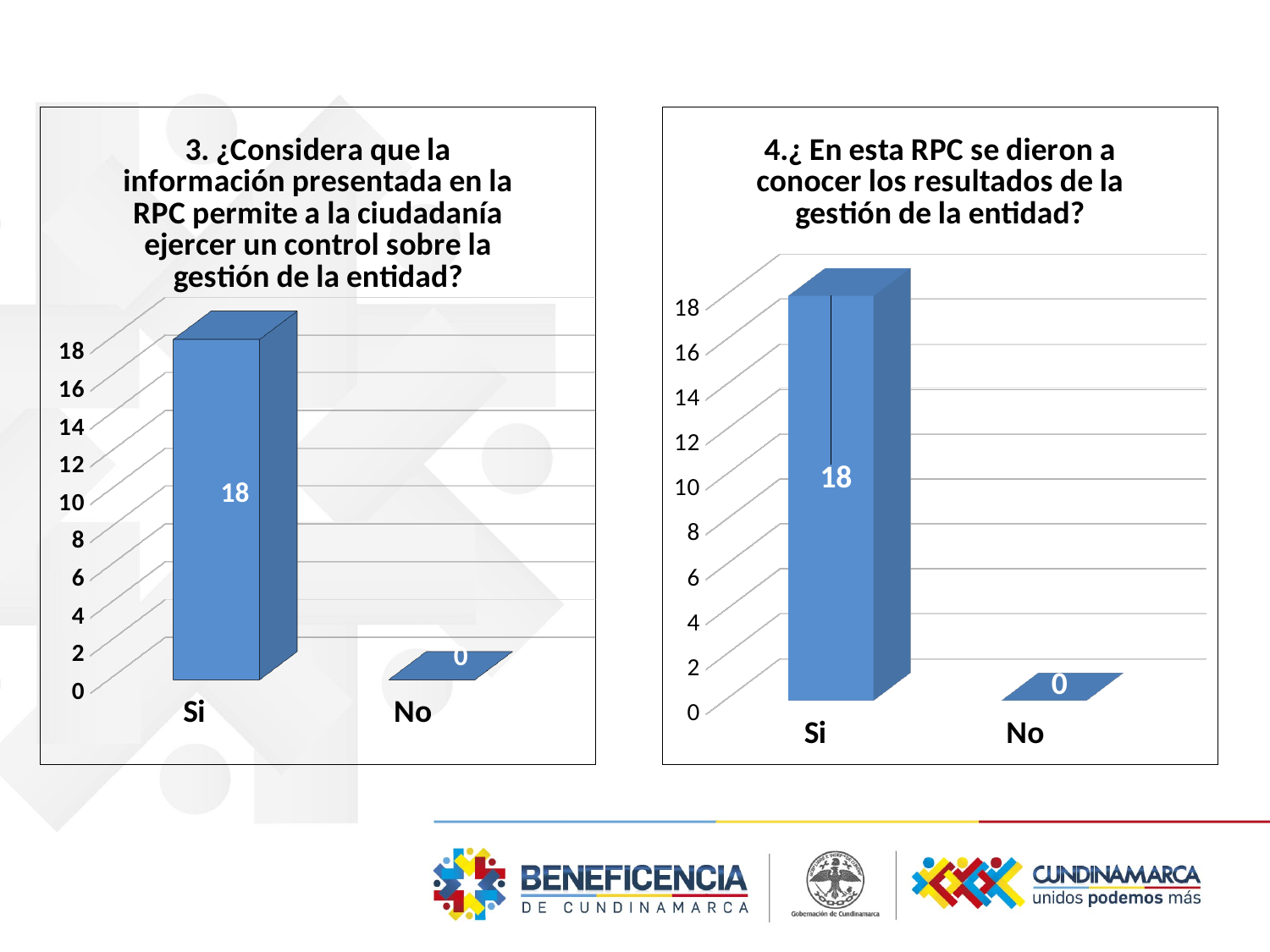
What kind of chart is the right chart (question 4)? bar chart In the left chart (question 3), which category has the highest value? Si In the right chart (question 4), which is larger, the value for Si or the value for No? Si How many categories are shown in the left chart (question 3)? 2 In the left chart (question 3), what is the value for No? 0 In the right chart (question 4), is the value for Si greater or less than 10? greater In the left chart (question 3), what is the difference between the values for Si and No? 18 In the right chart (question 4), what is the value for Si? 18 What is the title of the right chart? 4.¿ En esta RPC se dieron a conocer los resultados de la gestión de la entidad? In the right chart (question 4), which category has the lowest value? No In the left chart (question 3), what is the value for Si? 18 In the right chart (question 4), what is the value for No? 0